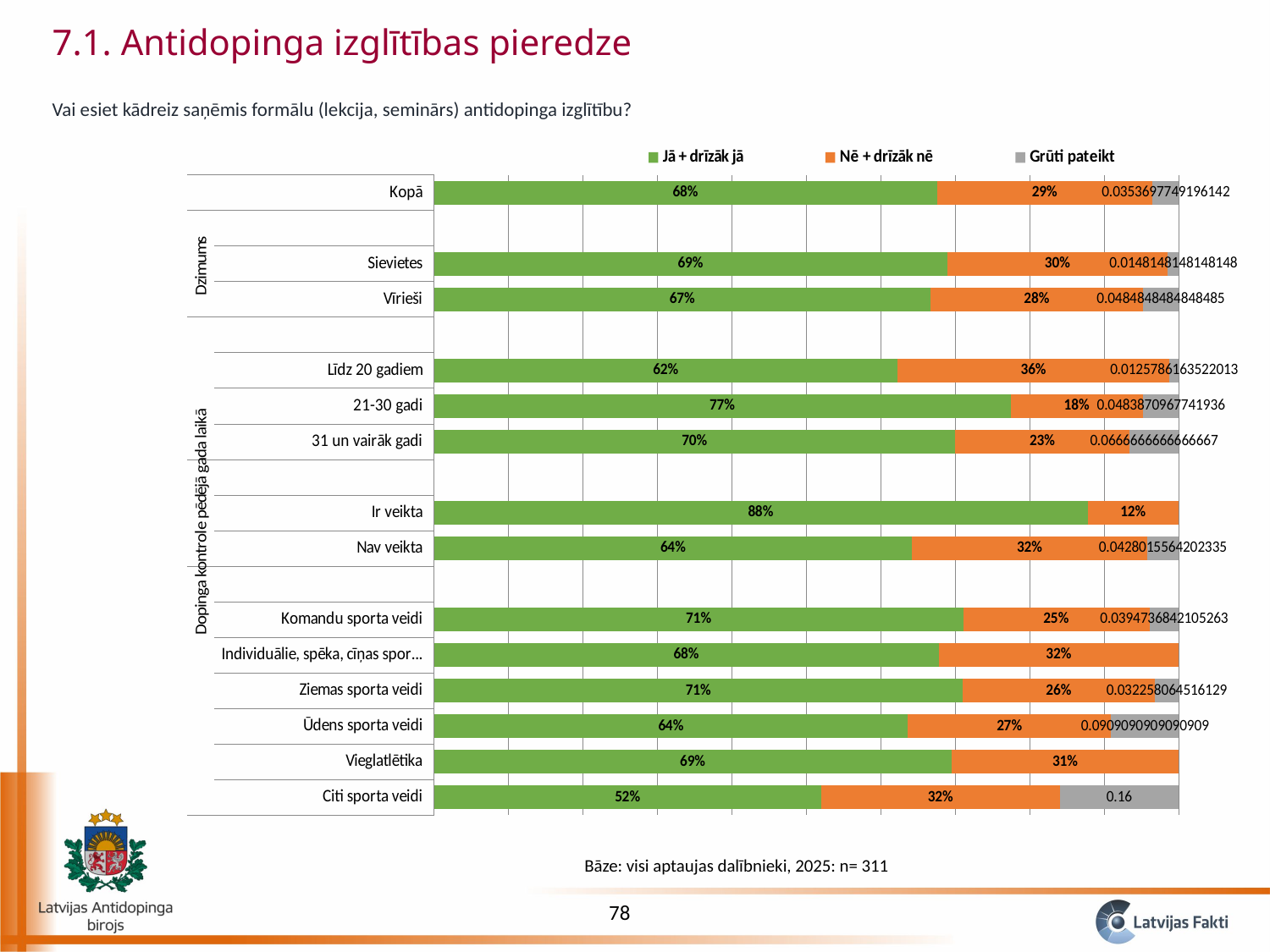
What is the value of "Grūti pateikt" for Citi sporta veidi? 0.16 Which category has the lowest value for "Jā + drīzāk jā"? Citi sporta veidi What is the value of "Jā + drīzāk jā" for Kopā? 68% How many series does the legend list? 3 Which category has the highest value for "Jā + drīzāk jā"? Ir veikta What is the difference in "Jā + drīzāk jā" between Ir veikta and Nav veikta? 24 percentage points What is the value of "Nē + drīzāk nē" for Līdz 20 gadiem? 36% Which colour represents the "Nē + drīzāk nē" series? Orange What kind of chart is shown on the slide? Stacked bar chart What is the value of "Jā + drīzāk jā" for Ir veikta? 88% How many categories are shown in the chart? 14 Which has a larger "Jā + drīzāk jā" value, 21-30 gadi or Līdz 20 gadiem? 21-30 gadi